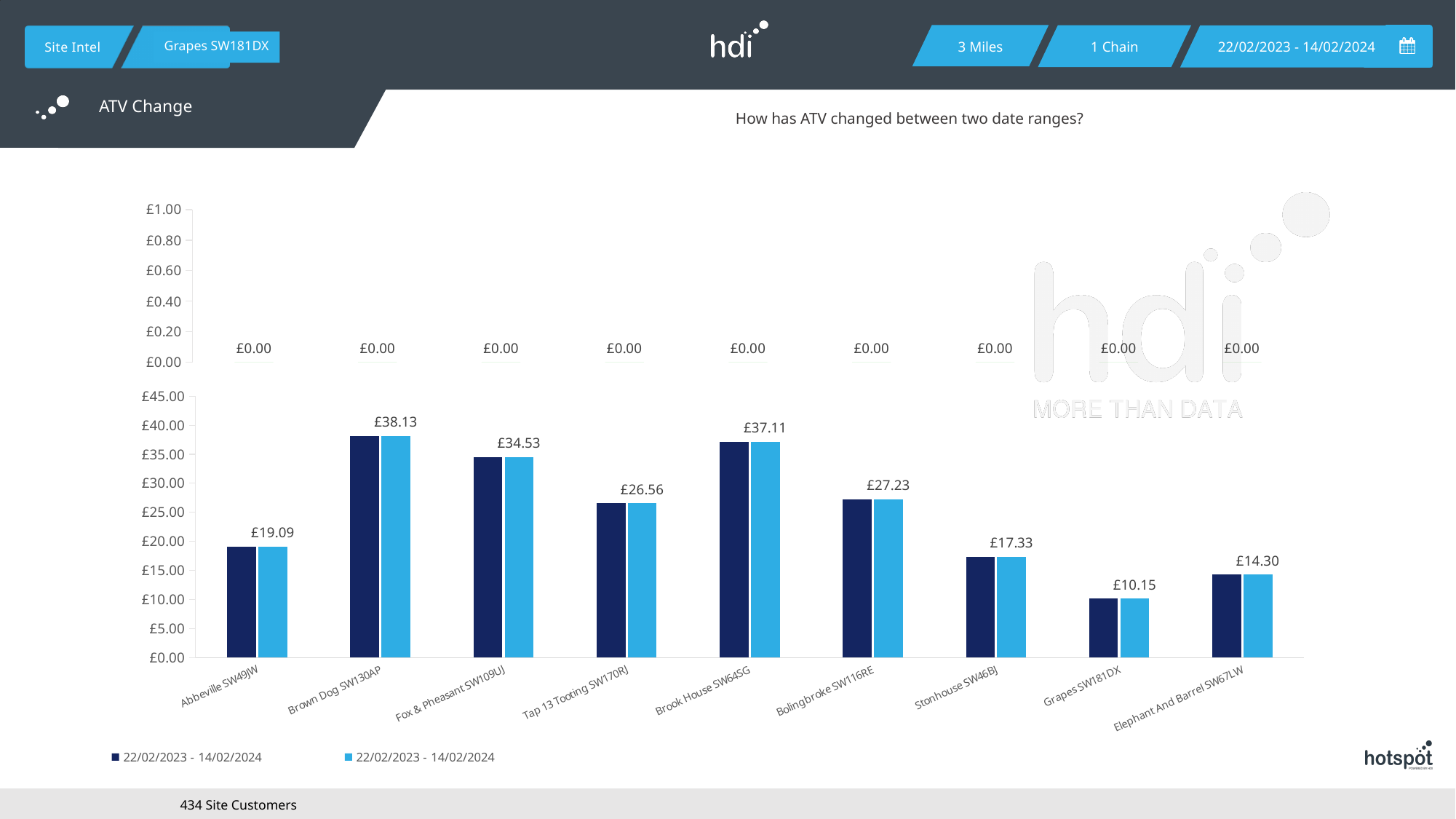
What is the ATV value shown for Grapes SW181DX in the lower bar chart? £10.15 How many series does the legend of the lower bar chart list? 2 In the upper chart, what value is labelled for Fox & Pheasant SW109UJ? £0.00 In the lower bar chart, which site has the highest ATV? Brown Dog SW130AP What is the ATV value shown for Brown Dog SW130AP in the lower bar chart? £38.13 In the lower bar chart, what is the difference between the ATV for Abbeville SW49JW and Stonhouse SW46BJ? £1.76 In the lower bar chart, which site has the lowest ATV? Grapes SW181DX How many sites are shown on the x axis of the lower bar chart? 9 In the lower bar chart, which has a higher ATV: Bolingbroke SW116RE or Tap 13 Tooting SW170RJ? Bolingbroke SW116RE What is the ATV value shown for Elephant And Barrel SW67LW in the lower bar chart? £14.30 What type of chart is used to show ATV by site on this slide? Bar chart In the lower bar chart, what is the difference between the ATV for Brown Dog SW130AP and Brook House SW64SG? £1.02